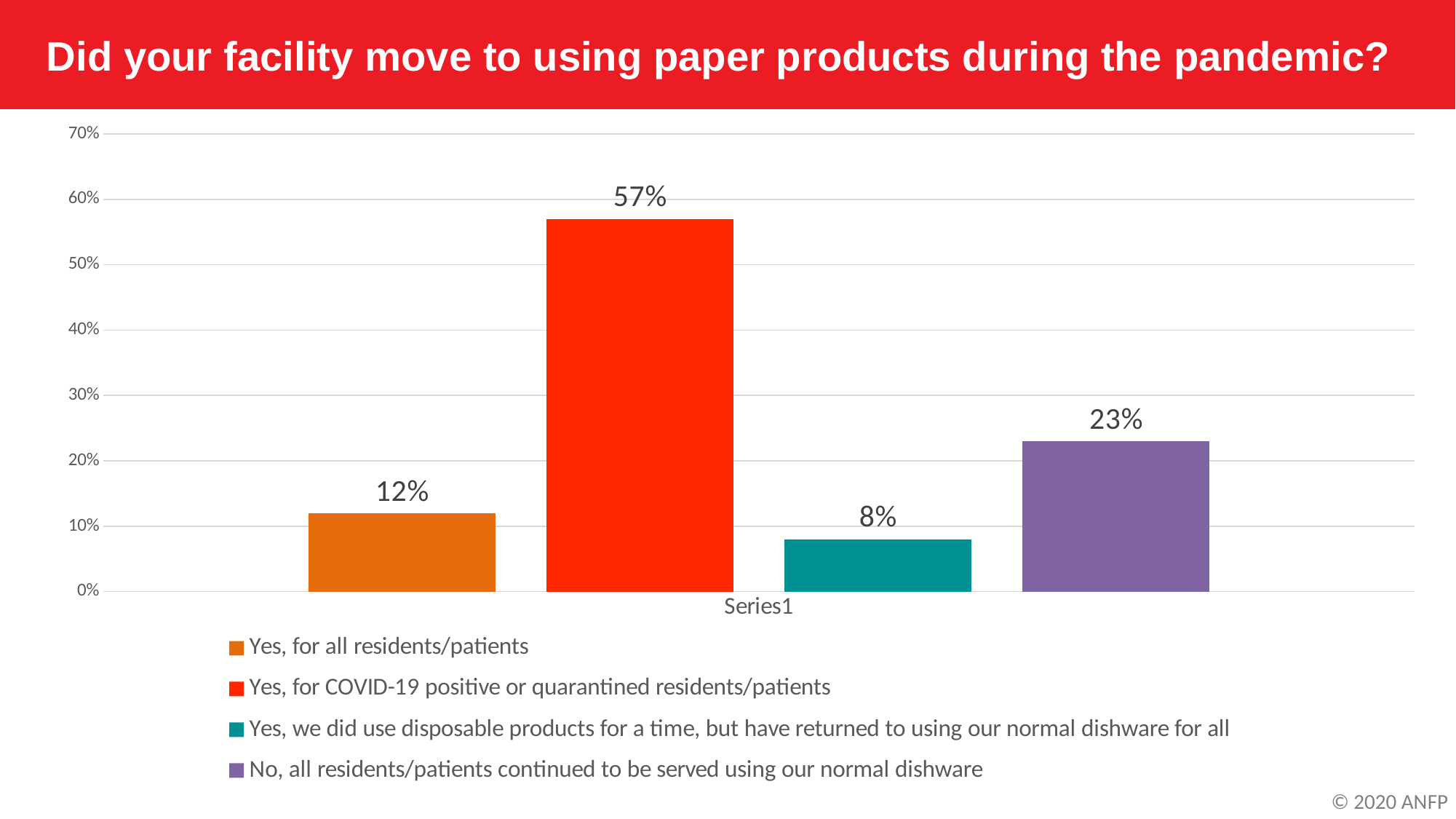
What percentage of facilities used disposable products for a time but have returned to using normal dishware for all? 8% Is the value for 'Yes, for COVID-19 positive or quarantined residents/patients' greater or less than 50%? greater Which response has the highest percentage? Yes, for COVID-19 positive or quarantined residents/patients What percentage of facilities reported that all residents/patients continued to be served using normal dishware? 23% What colour is the bar for 'Yes, for all residents/patients'? Orange What kind of chart is shown on the slide? Bar chart What percentage of facilities moved to paper products for all residents/patients? 12% Which response has the lowest percentage? Yes, we did use disposable products for a time, but have returned to using our normal dishware for all How many response categories are shown in the chart? 4 Which is larger: the percentage for 'Yes, for all residents/patients' or the percentage for 'No, all residents/patients continued to be served using our normal dishware'? No, all residents/patients continued to be served using our normal dishware What is the difference in percentage points between the 'Yes, for COVID-19 positive or quarantined residents/patients' response and the 'No, all residents/patients continued to be served using our normal dishware' response? 34% What percentage of facilities moved to paper products for COVID-19 positive or quarantined residents/patients? 57%